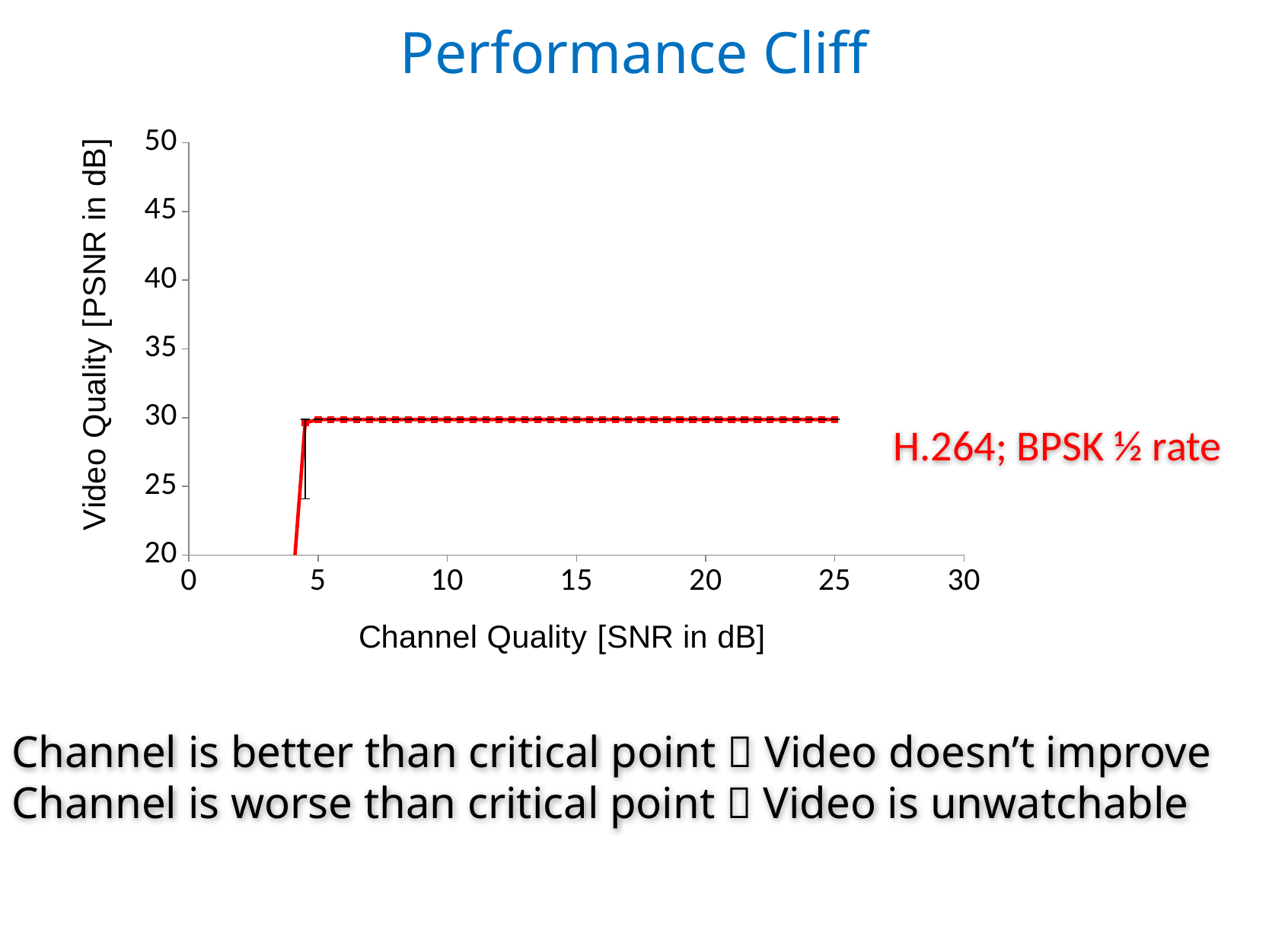
What kind of chart is shown on the slide? line chart Does the video quality rise or fall as channel quality increases from about 4 dB to 5 dB? rises How does the video quality change as channel quality increases from 5 dB to 25 dB? stays flat What is the highest value shown on the y axis of the chart? 50 What is the label of the x axis of the chart? Channel Quality [SNR in dB] Is the video quality at a channel quality of 25 dB greater or less than 45? less Is the video quality at a channel quality of 10 dB greater or less than 35? less Is the video quality at a channel quality of 5 dB greater or less than 20? greater What is the title of the chart on the slide? Performance Cliff